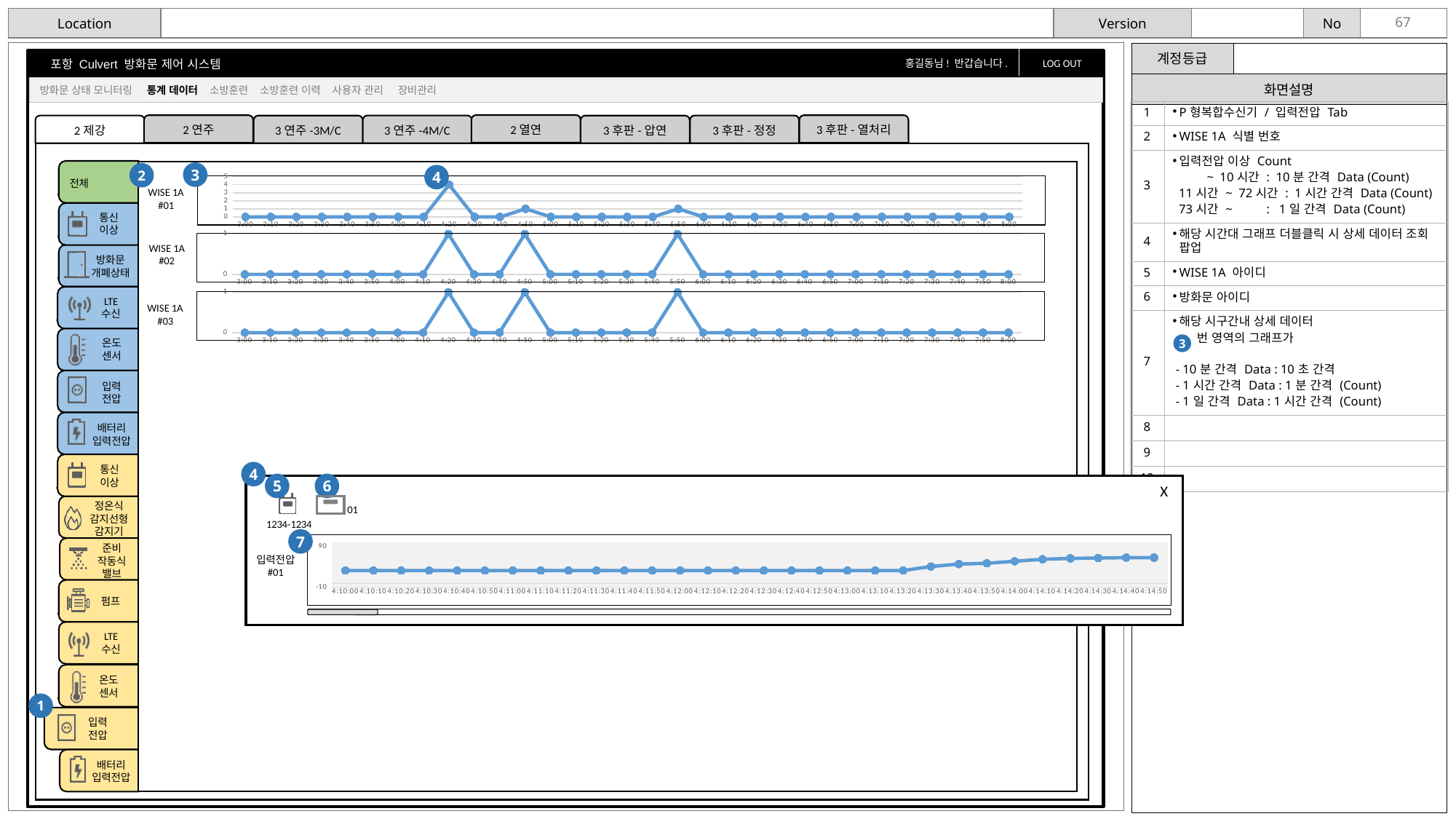
How many line charts are shown on the slide in total? 4 In the 입력전압 #01 chart in the popup, is the value at 4:10:00 greater or less than 90? less In the WISE 1A #01 chart, which is larger, the value at 4:20 or the value at 4:50? 4:20 In the WISE 1A #02 chart, what is the value at 4:20? 1 In the 입력전압 #01 chart in the popup, do the values rise or fall toward the right end of the x axis? rise In the WISE 1A #01 chart, at which time is the value highest? 4:20 What kind of chart is the WISE 1A #01 chart? line chart In the WISE 1A #02 chart, what is the value at 6:00? 0 What is the label of the chart shown in the popup window? 입력전압 #01 In the WISE 1A #01 chart, is the value at 4:20 greater or less than 3? greater In the WISE 1A #03 chart, what is the value at 3:00? 0 In the WISE 1A #03 chart, which is larger, the value at 4:50 or the value at 5:00? 4:50